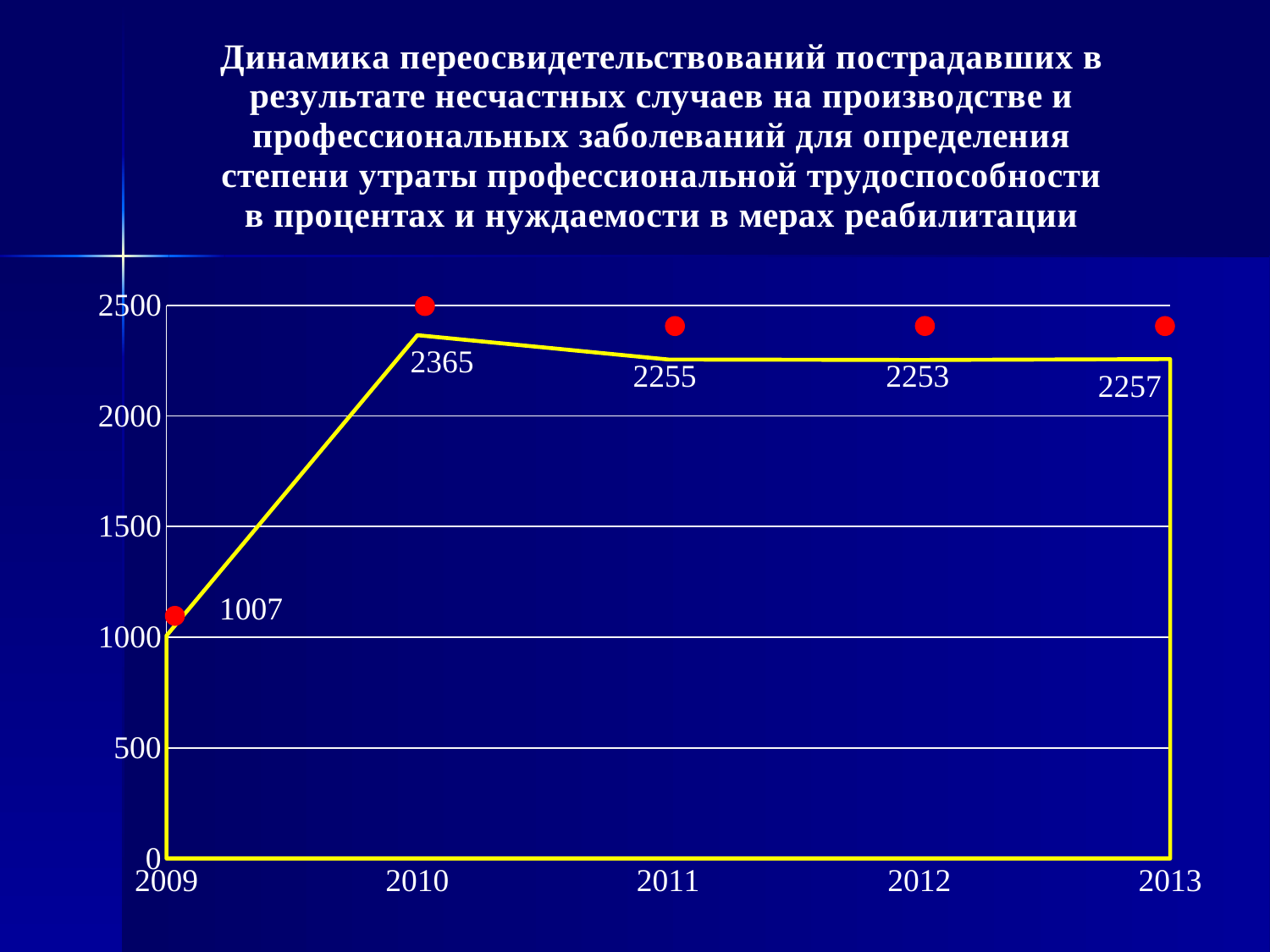
What is the difference between the values for 2010 and 2009? 1358 What is the value for 2009? 1007 What is the value for 2010? 2365 What is the difference between the values for 2010 and 2011? 110 Which is larger, the value for 2009 or the value for 2012? 2012 Which year has the lowest value? 2009 Is the value for 2011 greater or less than 2000? greater Does the value rise or fall from 2009 to 2010? rise What kind of chart is shown on the slide? area chart What is the value for 2013? 2257 Which year has the highest value? 2010 How many years are plotted on the x axis? 5